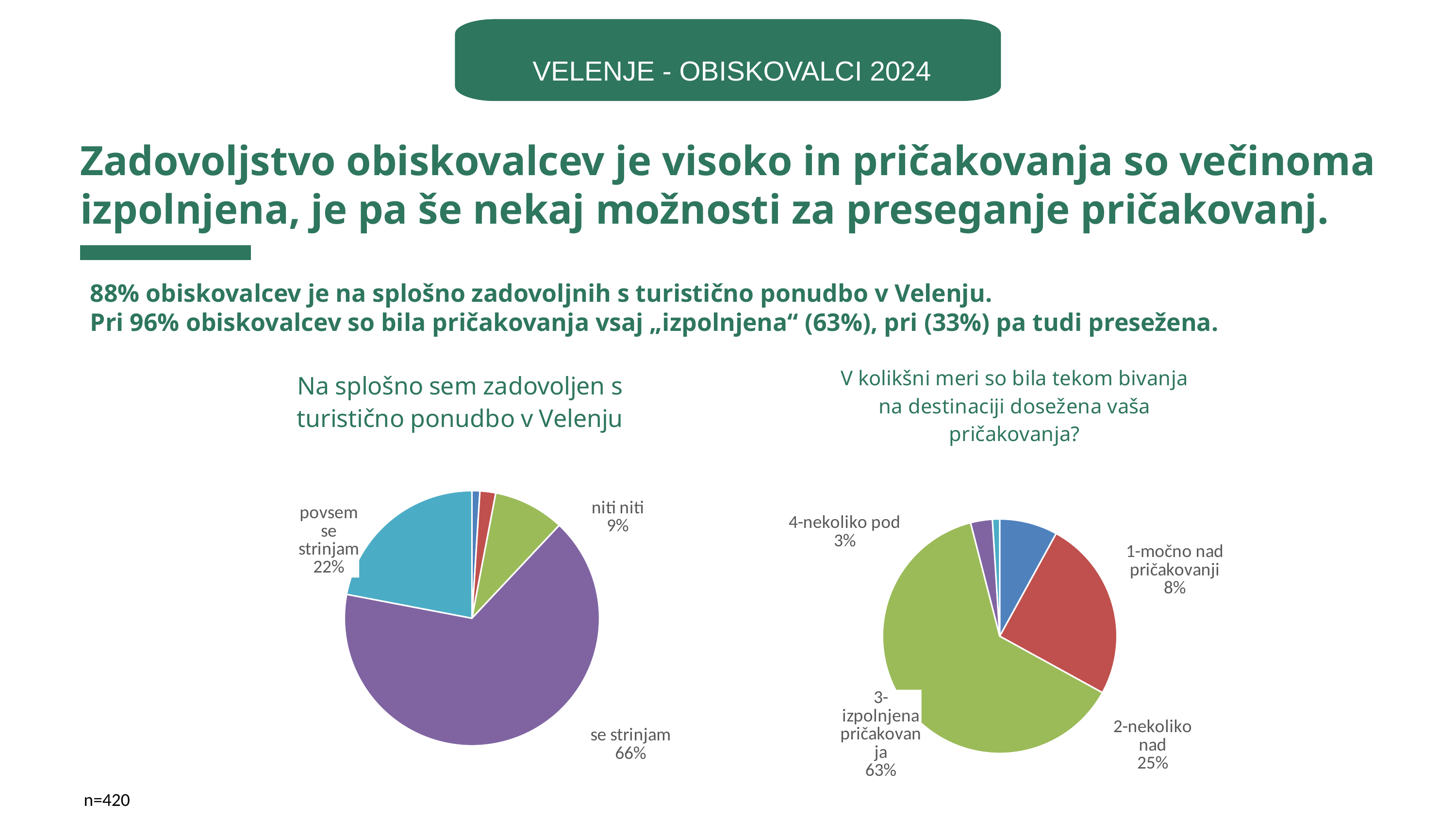
In the right pie chart (V kolikšni meri so bila tekom bivanja na destinaciji dosežena vaša pričakovanja?), what share of respondents answered "3-izpolnjena pričakovanja"? 63% In the right pie chart (V kolikšni meri so bila tekom bivanja na destinaciji dosežena vaša pričakovanja?), which is larger: "1-močno nad pričakovanji" or "2-nekoliko nad"? 2-nekoliko nad In the left pie chart (Na splošno sem zadovoljen s turistično ponudbo v Velenju), how many percentage points larger is "se strinjam" than "povsem se strinjam"? 44 percentage points In the left pie chart (Na splošno sem zadovoljen s turistično ponudbo v Velenju), which labeled category has the largest share? se strinjam In the left pie chart (Na splošno sem zadovoljen s turistično ponudbo v Velenju), what share of respondents answered "se strinjam"? 66% In the right pie chart (V kolikšni meri so bila tekom bivanja na destinaciji dosežena vaša pričakovanja?), what share of respondents answered "1-močno nad pričakovanji"? 8% In the left pie chart (Na splošno sem zadovoljen s turistično ponudbo v Velenju), what share of respondents answered "niti niti"? 9% In the right pie chart (V kolikšni meri so bila tekom bivanja na destinaciji dosežena vaša pričakovanja?), what share of respondents answered "4-nekoliko pod"? 3% What type of chart is used for the two charts on the slide? Pie chart In the left pie chart (Na splošno sem zadovoljen s turistično ponudbo v Velenju), what share of respondents answered "povsem se strinjam"? 22% In the right pie chart (V kolikšni meri so bila tekom bivanja na destinaciji dosežena vaša pričakovanja?), what share of respondents answered "2-nekoliko nad"? 25% In the right pie chart (V kolikšni meri so bila tekom bivanja na destinaciji dosežena vaša pričakovanja?), how many percentage points larger is "3-izpolnjena pričakovanja" than "2-nekoliko nad"? 38 percentage points